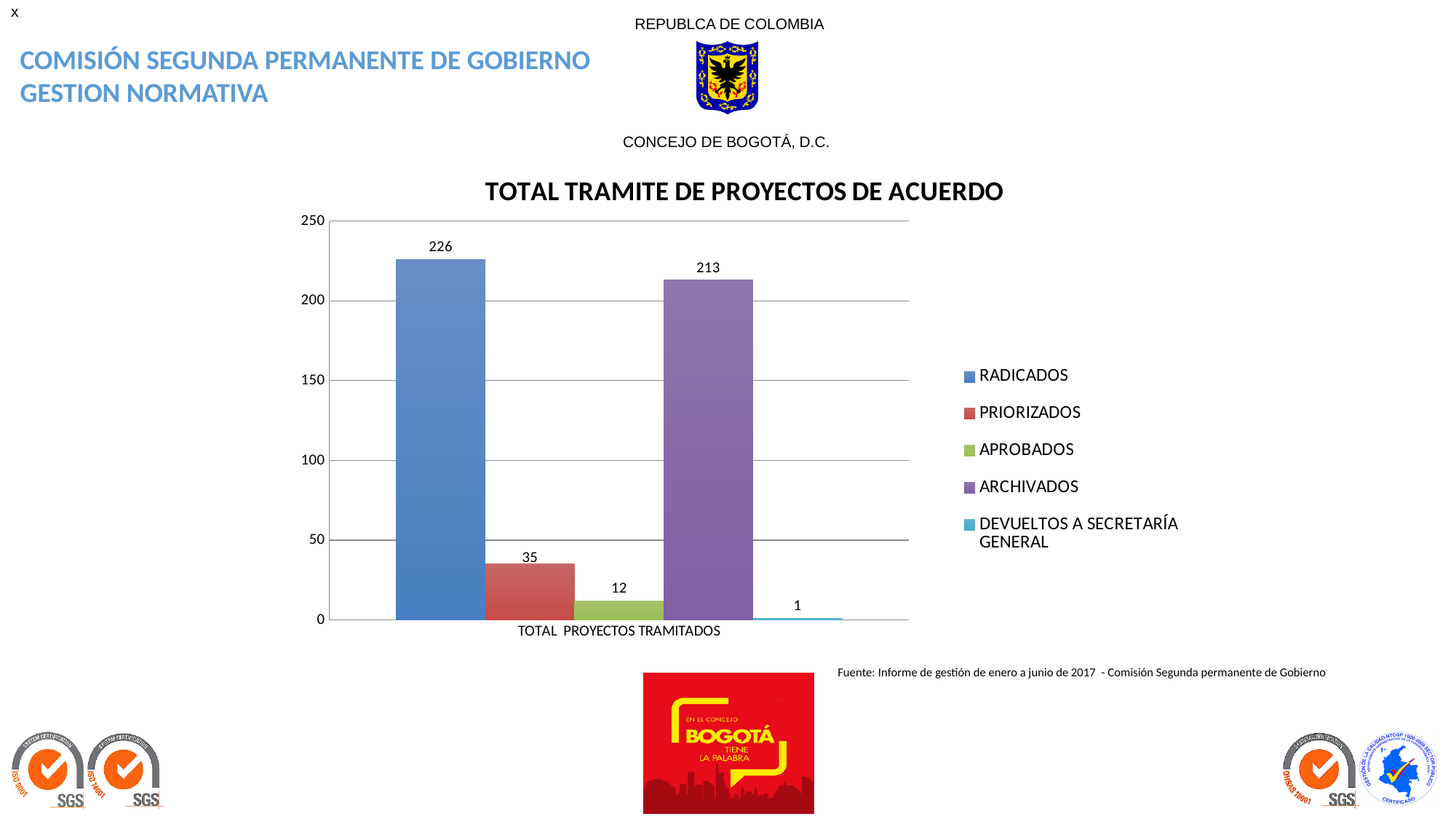
What is the title of the chart? TOTAL TRAMITE DE PROYECTOS DE ACUERDO What is the value for DEVUELTOS A SECRETARÍA GENERAL? 1 What is the value for RADICADOS? 226 Which series has the highest value? RADICADOS What is the difference between RADICADOS and ARCHIVADOS? 13 What kind of chart is shown? bar chart What is the value for PRIORIZADOS? 35 Which series has the lowest value? DEVUELTOS A SECRETARÍA GENERAL What is the value for APROBADOS? 12 How many series does the legend list? 5 What is the value for ARCHIVADOS? 213 Which is larger, PRIORIZADOS or APROBADOS? PRIORIZADOS